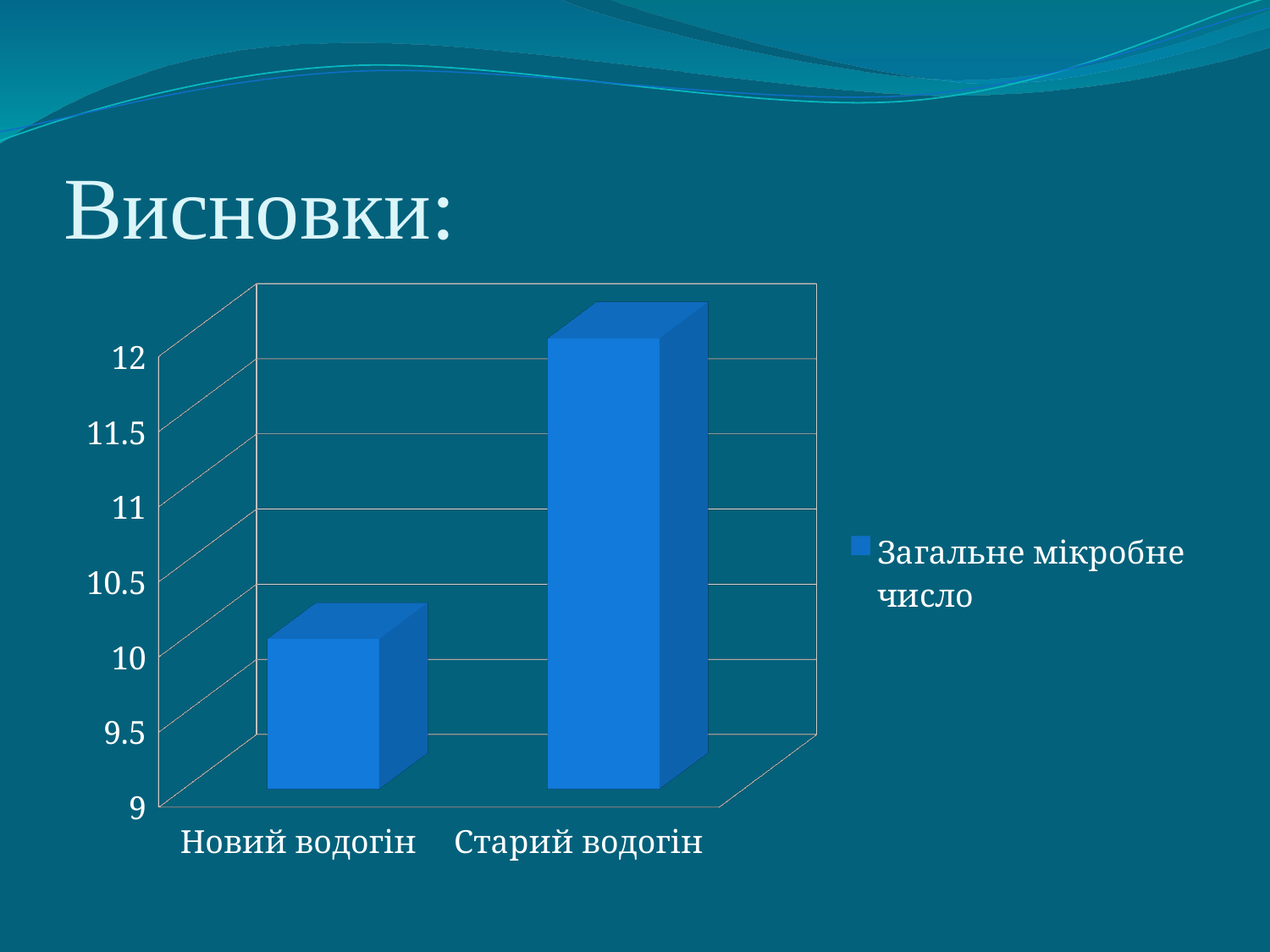
How many categories are shown on the x axis of the chart? 2 Is the value for Старий водогін greater or less than 11? greater Is the value for Новий водогін greater or less than 11? less Which category has the lowest value in the chart? Новий водогін Which category has the highest value in the chart? Старий водогін Is the value for Новий водогін greater or less than 9.5? greater Do the values rise or fall from Новий водогін to Старий водогін? rise How many series does the chart legend list? 1 What is the title of the slide containing the chart? Висновки: What kind of chart is shown on the slide? bar chart What series name is shown in the chart legend? Загальне мікробне число Which is larger, the value for Новий водогін or the value for Старий водогін? Старий водогін